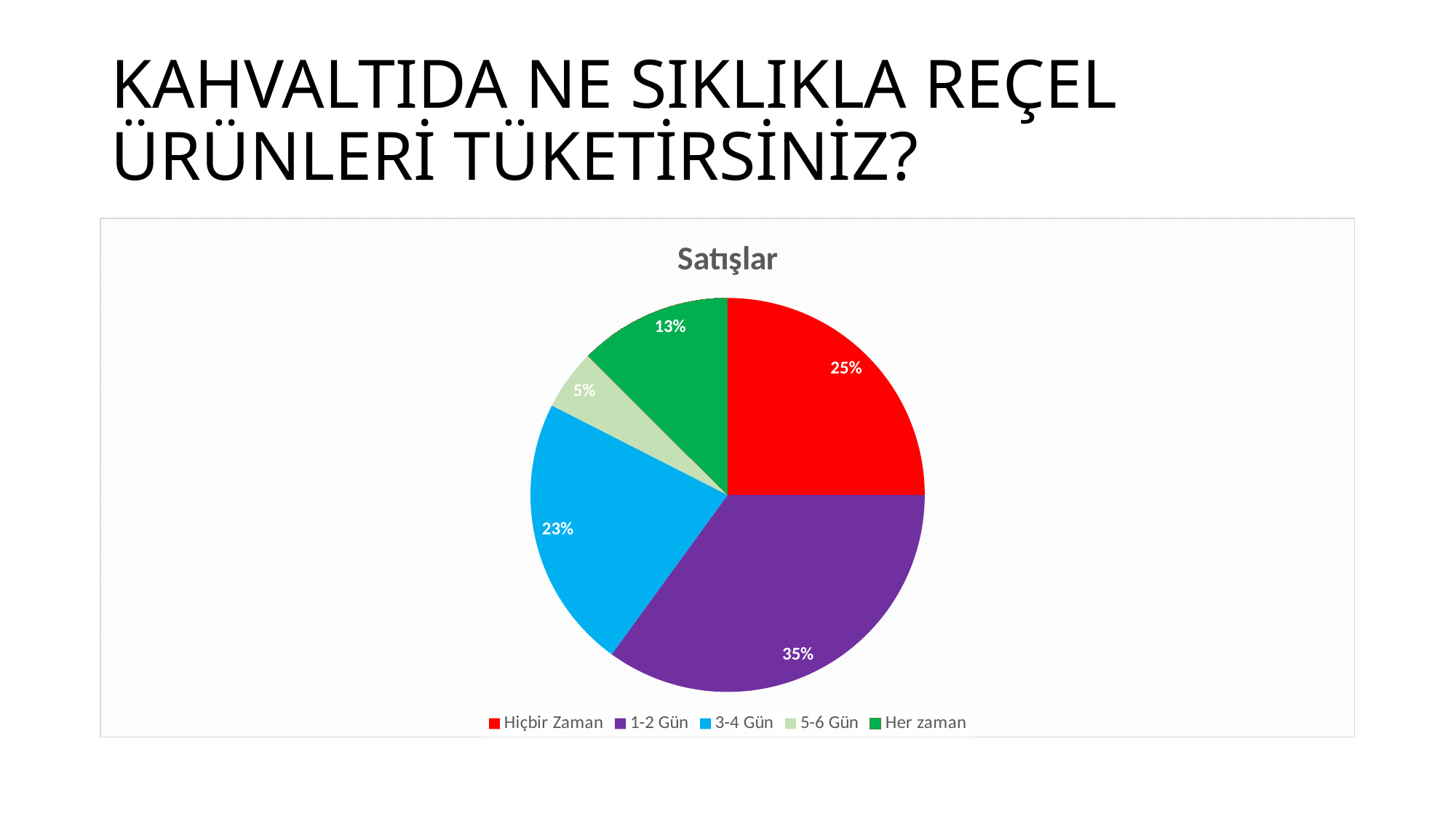
Which category has the largest slice of the pie? 1-2 Gün What is the difference in percentage points between the '1-2 Gün' slice and the 'Hiçbir Zaman' slice? 10 What percentage of the pie is the '5-6 Gün' slice? 5% Which category has the smallest slice of the pie? 5-6 Gün What percentage of the pie is the '3-4 Gün' slice? 23% What percentage of the pie is the '1-2 Gün' slice? 35% What percentage of the pie is the 'Hiçbir Zaman' slice? 25% How many categories does the legend list? 5 What percentage of the pie is the 'Her zaman' slice? 13% Which slice is larger, 'Her zaman' or '3-4 Gün'? 3-4 Gün What is the chart's title? Satışlar What kind of chart is shown on the slide? pie chart